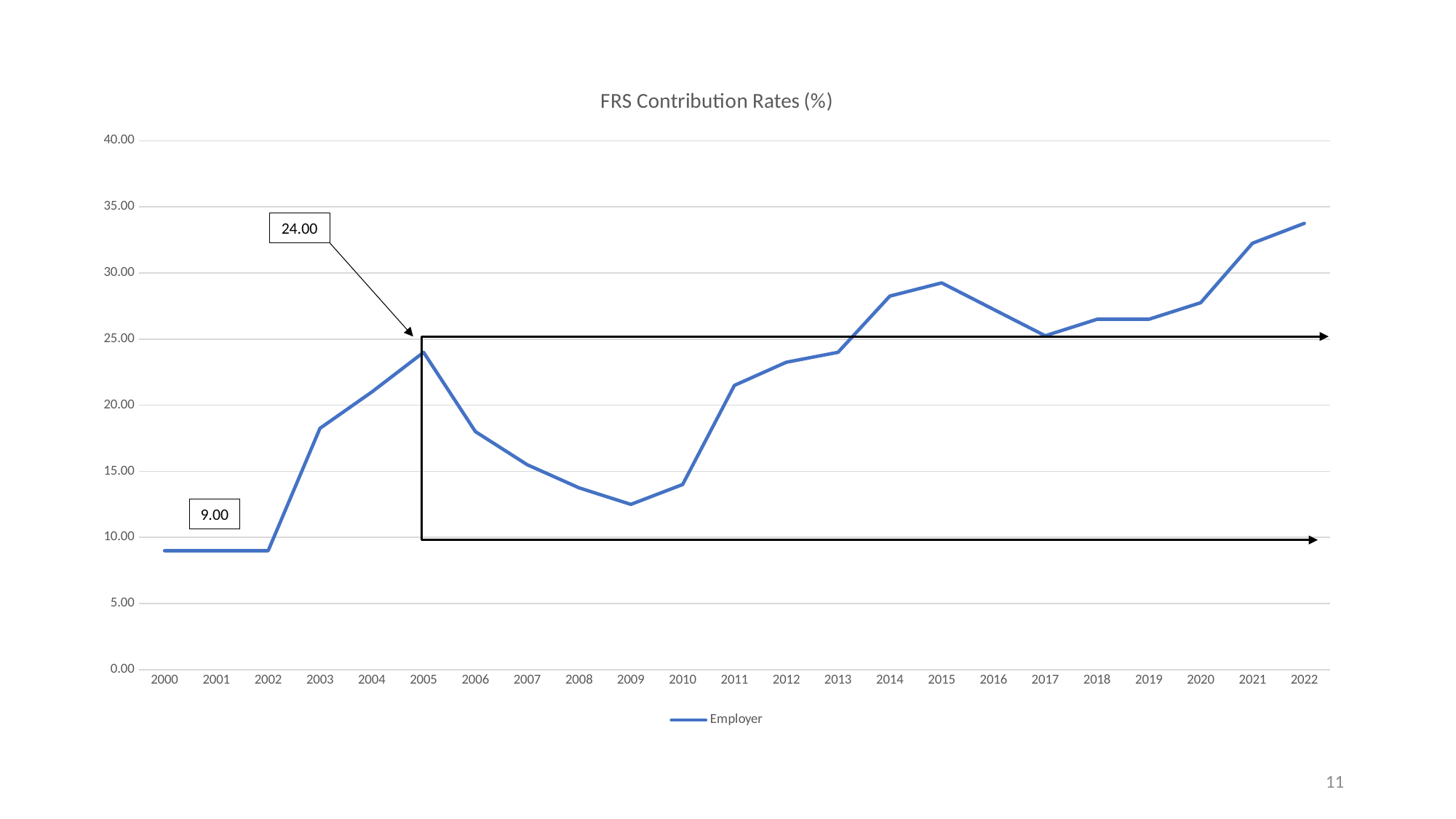
Is the value for 2021 greater or less than 30.00? greater What is the title of the chart? FRS Contribution Rates (%) What is the name of the series shown in the legend? Employer Which year has the highest Employer contribution rate? 2022 Do the values rise or fall from 2005 to 2009? fall How many series does the legend list? 1 What is the Employer contribution rate labelled for 2005? 24.00 What is the Employer contribution rate labelled for 2000? 9.00 Is the value for 2009 greater or less than 15.00? less How many years are plotted along the x axis? 23 What kind of chart is shown on the slide? line chart Which year has the larger value, 2015 or 2017? 2015